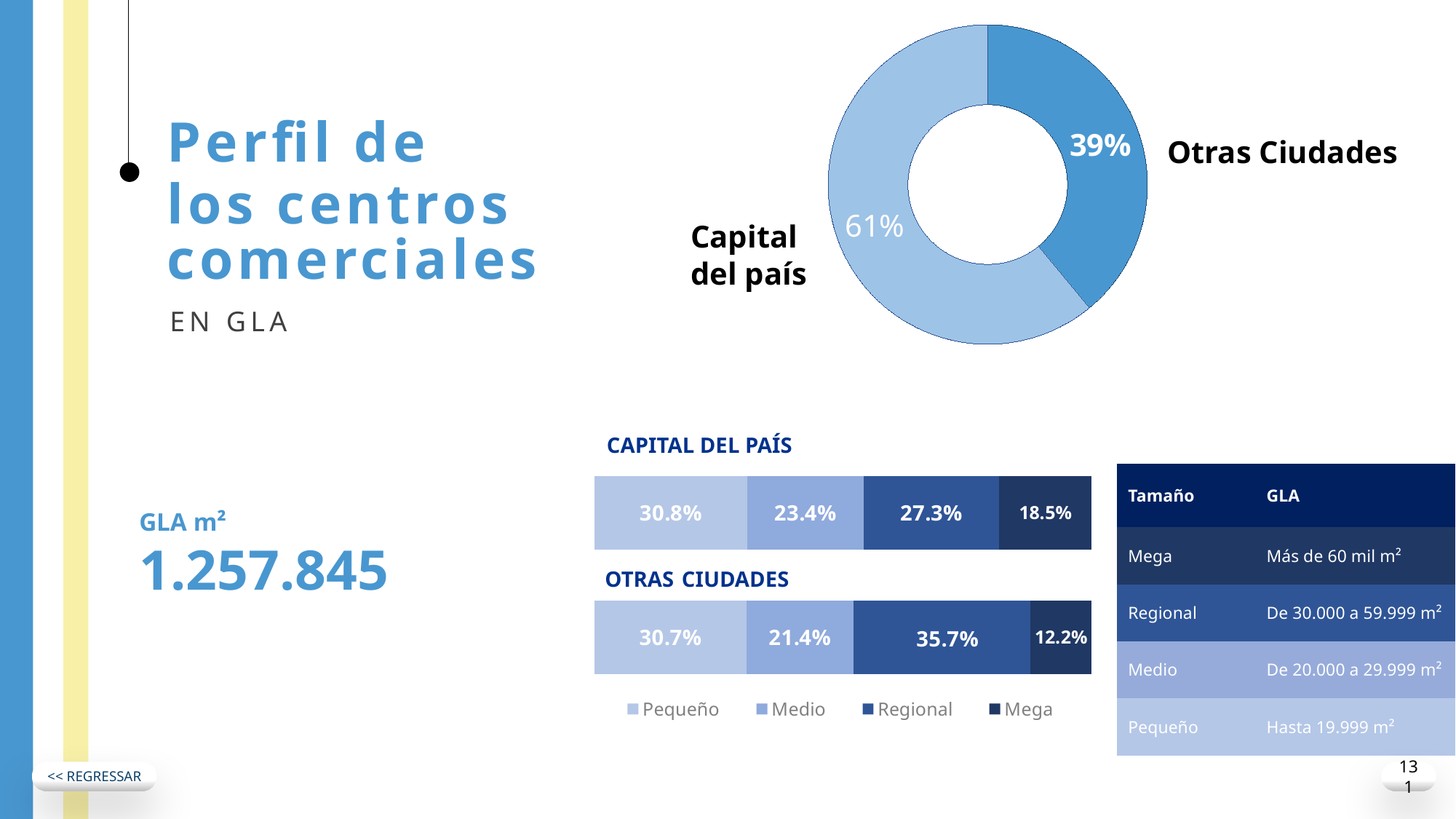
In the donut chart at the top, what share is labelled for Capital del país? 61% In the OTRAS CIUDADES stacked bar, which is larger, Medio or Regional? Regional What kind of chart is the chart at the top of the slide showing Capital del país and Otras Ciudades? Donut chart In the CAPITAL DEL PAÍS stacked bar, what is the value for Mega? 18.5% In the OTRAS CIUDADES stacked bar, which segment is the smallest? Mega In the donut chart at the top, which segment is larger, Capital del país or Otras Ciudades? Capital del país In the donut chart at the top, what share is labelled for Otras Ciudades? 39% In the CAPITAL DEL PAÍS stacked bar, what is the value for Pequeño? 30.8% In the OTRAS CIUDADES stacked bar, what is the value for Regional? 35.7% How many series does the legend below the stacked bar charts list? 4 In the CAPITAL DEL PAÍS stacked bar, which segment is the largest? Pequeño What is the difference between the Regional value in the OTRAS CIUDADES bar and the Regional value in the CAPITAL DEL PAÍS bar? 8.4%